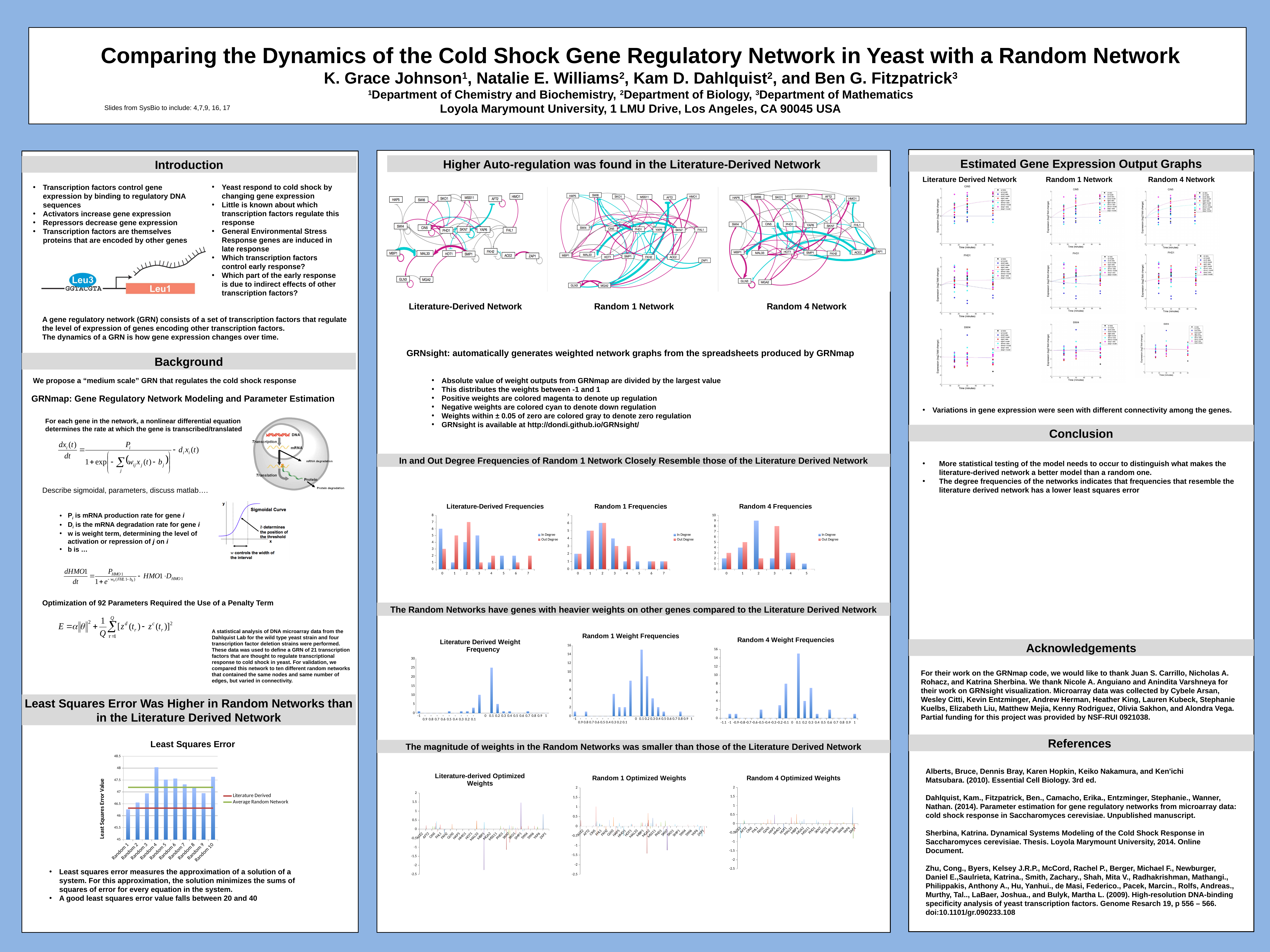
In the Least Squares Error chart, which random network has the highest least squares error value? Random 4 In the Least Squares Error chart, is the value for Random 1 greater or less than 47? less How many series does the legend of the Literature-Derived Frequencies chart list? 2 In the Random 4 Frequencies chart, is the In Degree frequency at degree 2 greater or less than 8? greater In the Random 4 Frequencies chart, which degree value has the highest In Degree frequency? 2 In the Least Squares Error chart, is the value for Random 4 greater or less than 47.5? greater In the Least Squares Error chart, which random network has the lowest least squares error value? Random 1 What kind of chart is the Least Squares Error chart? bar chart How many entries does the legend of the Least Squares Error chart list? 2 In the Random 4 Frequencies chart, at degree 3, which is larger: In Degree or Out Degree? Out Degree How many random networks are plotted as bars in the Least Squares Error chart? 10